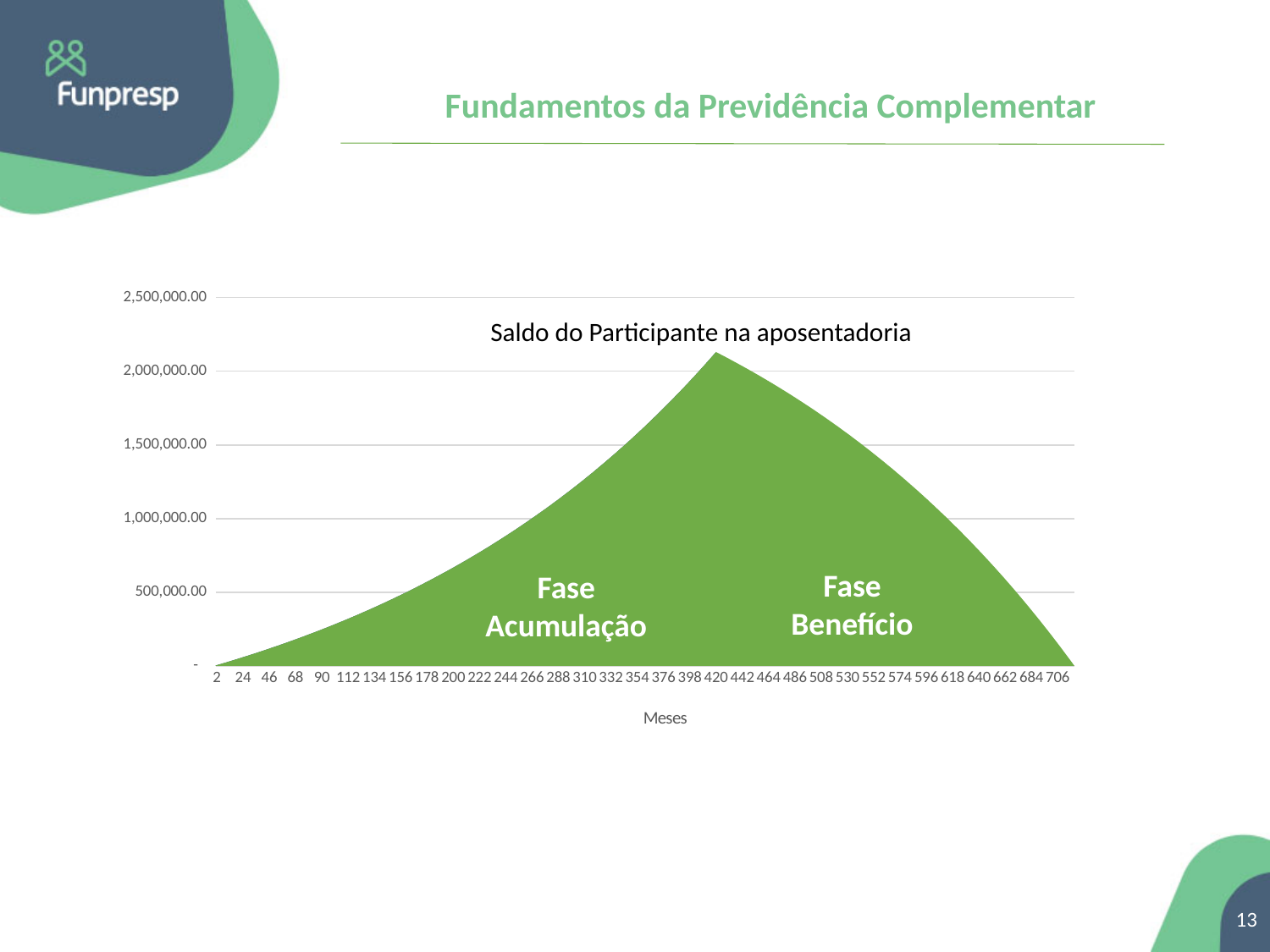
How does the participant's balance change along the x axis? It rises, then falls Is the peak value of the balance greater or less than 1,500,000.00? greater What is the highest value shown on the y axis? 2,500,000.00 Is the balance at month 310 greater or less than 1,000,000.00? greater Does the balance rise or fall during the 'Fase Acumulação'? rises What kind of chart is shown on the slide? area chart Does the balance rise or fall during the 'Fase Benefício'? falls What is the title of the chart? Saldo do Participante na aposentadoria Is the balance at month 640 greater or less than 1,000,000.00? less What is the label of the x axis? Meses